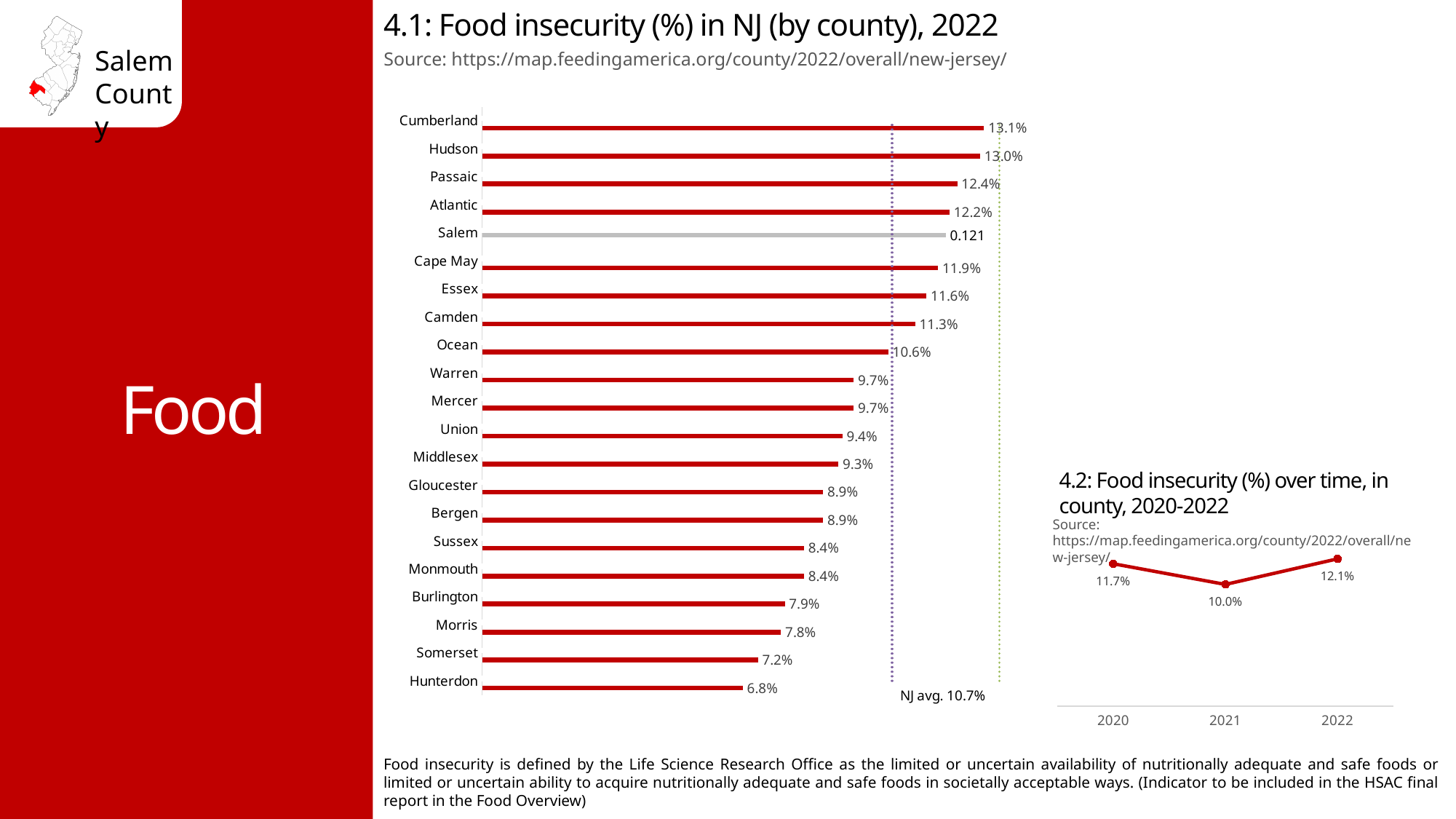
In chart 4.1, how many counties are plotted? 21 In chart 4.1, which county has the lowest food insecurity rate? Hunterdon In chart 4.1 (Food insecurity in NJ by county, 2022), what is the value for Cumberland? 13.1% In chart 4.2, how does the value change from 2020 to 2022? It falls from 2020 to 2021, then rises in 2022 In chart 4.1, what NJ average value is marked on the chart? NJ avg. 10.7% In chart 4.1, which county has the highest food insecurity rate? Cumberland What kind of chart is chart 4.1? Bar chart In chart 4.2 (Food insecurity over time, 2020-2022), what is the value for 2021? 10.0% In chart 4.1, what data label is shown for Salem? 0.121 In chart 4.2, what is the difference between the 2022 and 2021 values? 2.1 percentage points In chart 4.1, what is the difference between the values for Cumberland and Hunterdon? 6.3 percentage points In chart 4.1, which has the higher value, Passaic or Atlantic? Passaic